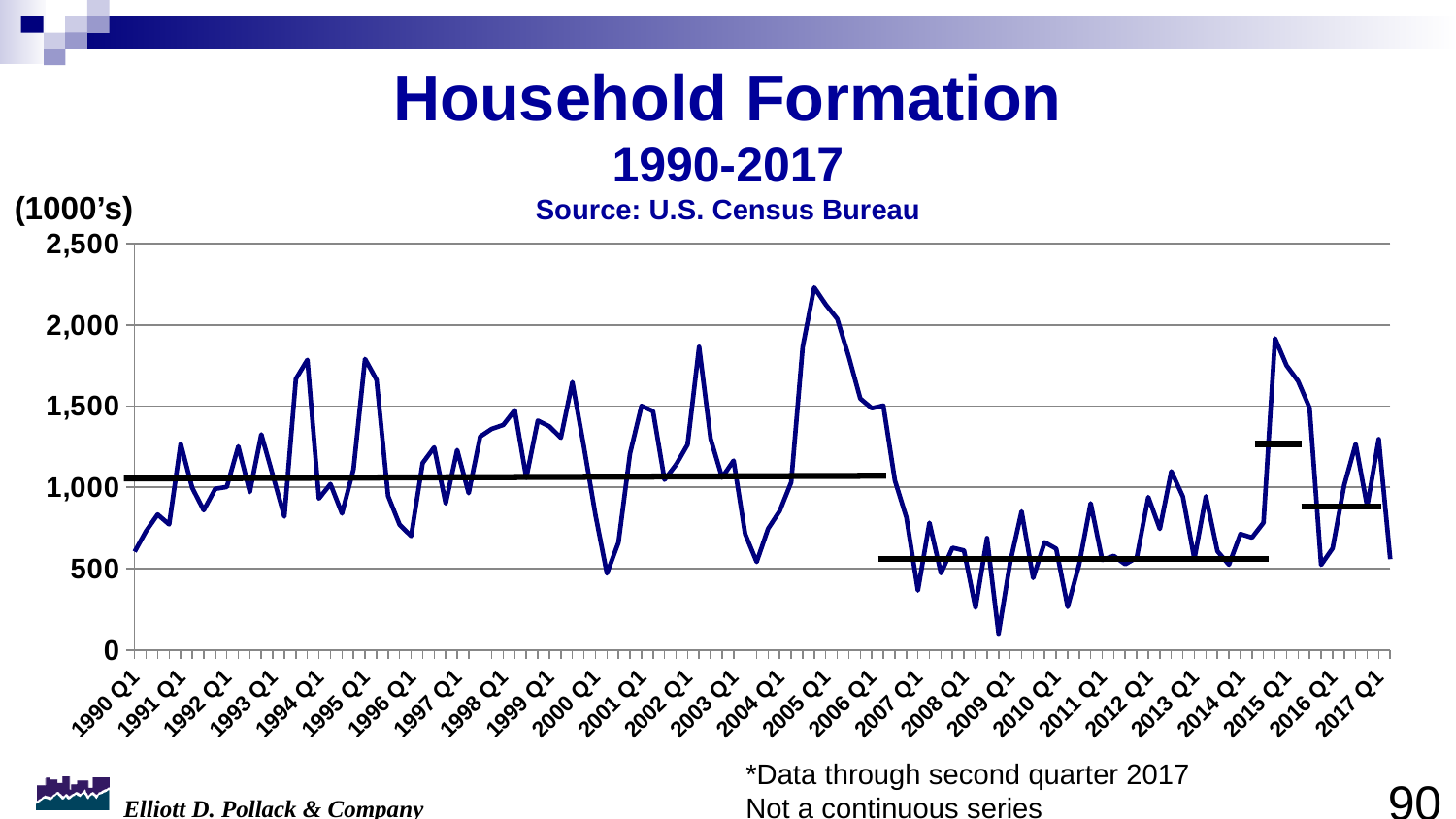
Does the line generally rise or fall between 2005 Q1 and 2008 Q1? fall What kind of chart is shown on the slide? line chart How many year labels (1990 Q1 through 2017 Q1) are shown on the x axis? 28 What source is cited for the chart data? U.S. Census Bureau Is the peak value reached around 2005 greater or less than 2,000? greater Is the value for 2015 Q1 greater or less than 1,500? greater What is the title of the chart? Household Formation 1990-2017 In which year does the line reach its lowest point? 2008 Is the value for 1990 Q1 greater or less than 1,000? less In which year does the line reach its highest point? 2004 What is the highest value shown on the y axis? 2,500